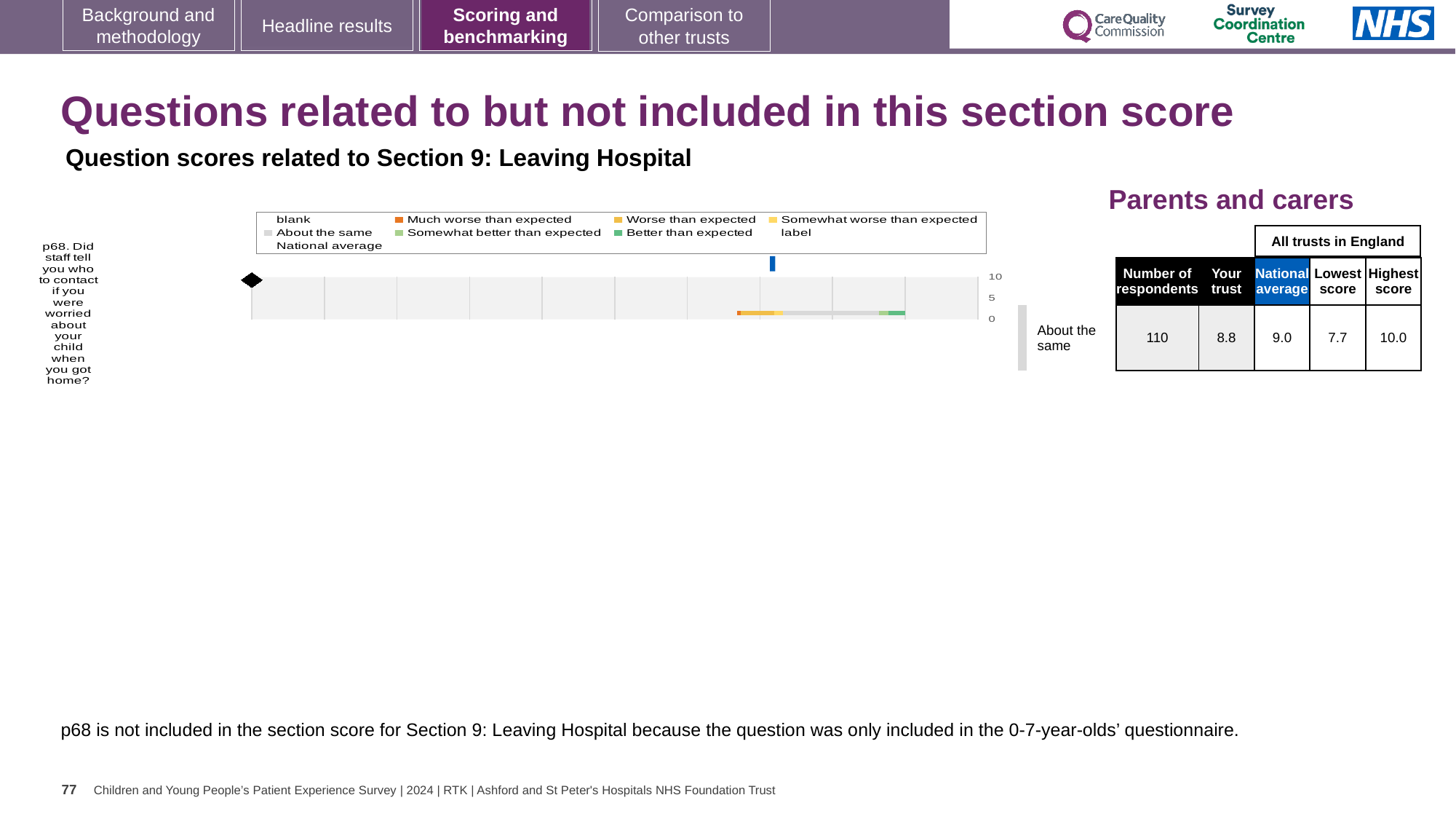
What is the lowest score among all trusts in England for p68? 7.7 What colour does the legend use for "Much worse than expected"? orange What kind of chart is shown for question p68? bar chart Which is larger for p68, the trust's score or the national average? national average What is the difference between the highest and lowest trust scores for p68? 2.3 Which question is plotted in the chart? p68. Did staff tell you who to contact if you were worried about your child when you got home? How many respondents answered p68 according to the table? 110 What is the "Your trust" score for p68 in the table next to the chart? 8.8 What is the highest score among all trusts in England for p68? 10.0 How many questions are plotted in the chart? 1 What is the national average score for p68 in the table next to the chart? 9.0